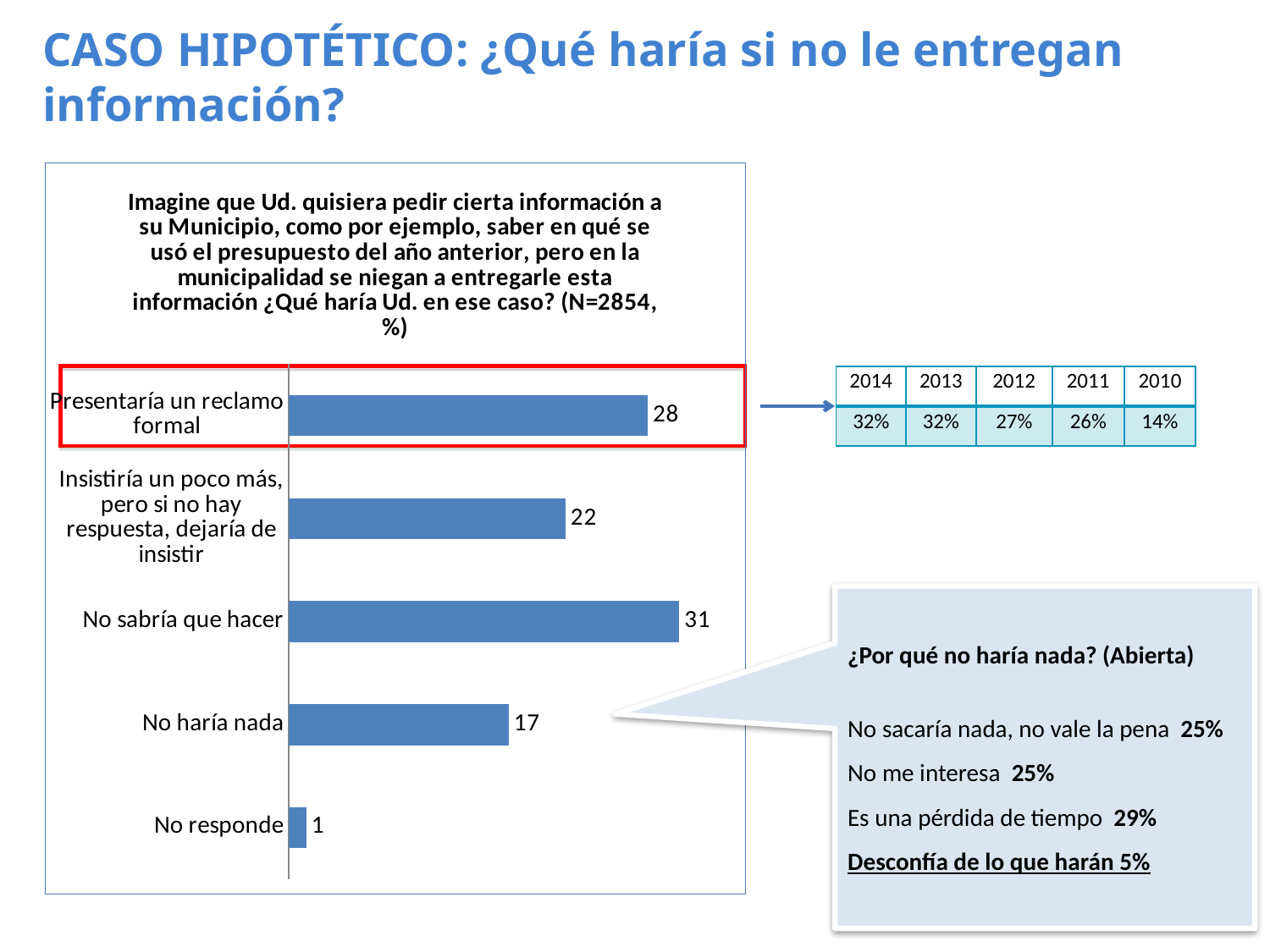
What is the sample size (N) stated in the chart title? 2854 What is the value for "No responde"? 1 What kind of chart is shown on the slide? Bar chart What is the difference between the values for "Insistiría un poco más, pero si no hay respuesta, dejaría de insistir" and "No haría nada"? 5 Which category has the lowest value? No responde What is the value for "No sabría que hacer"? 31 How many categories are shown in the bar chart? 5 What is the value for "No haría nada"? 17 What is the value for "Presentaría un reclamo formal"? 28 What is the difference between the values for "No sabría que hacer" and "Presentaría un reclamo formal"? 3 Which category has the highest value? No sabría que hacer Which is larger: the value for "Presentaría un reclamo formal" or the value for "No haría nada"? Presentaría un reclamo formal